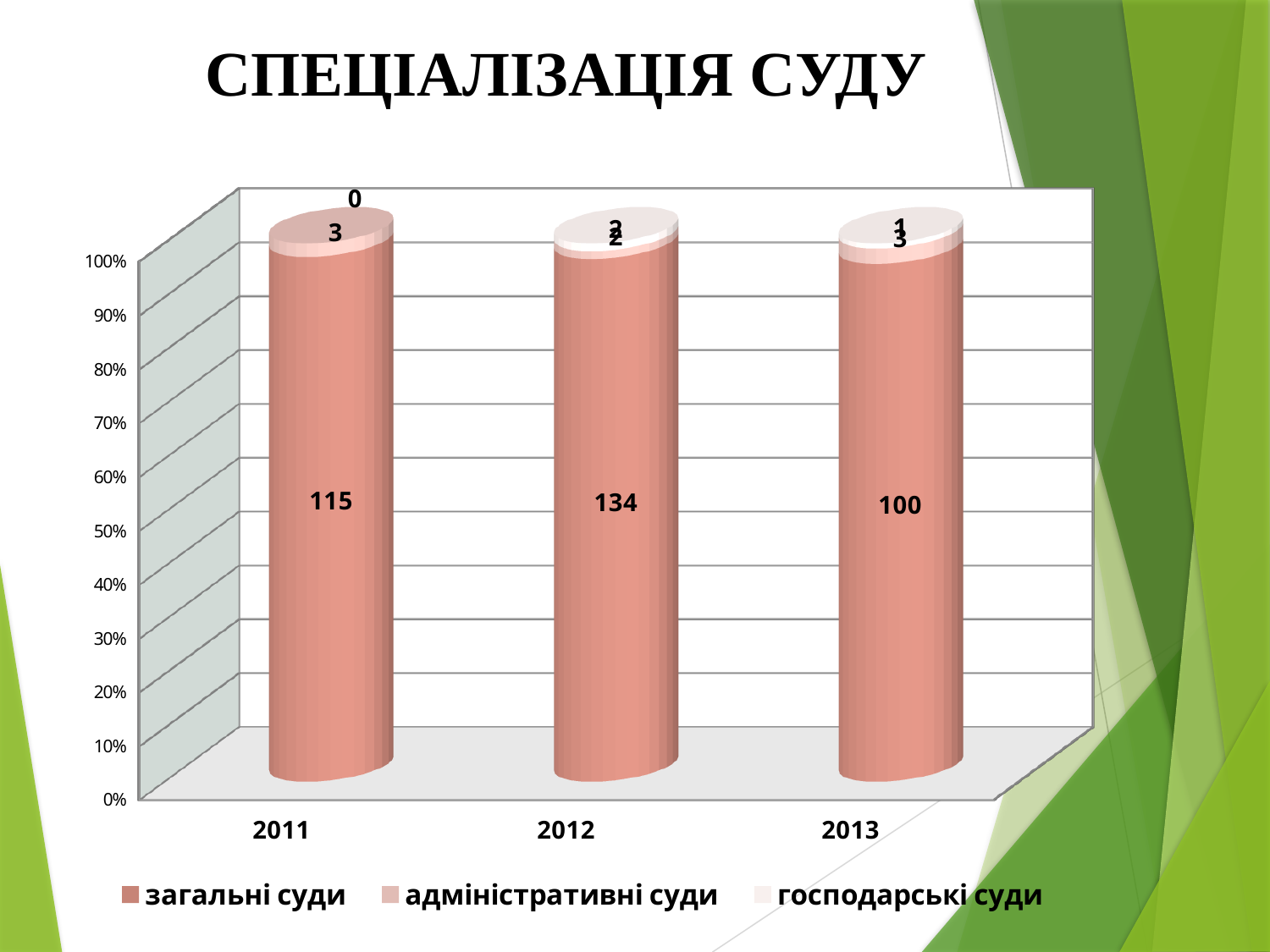
What is the value for загальні суди in 2012? 134 What is the difference between the загальні суди values for 2012 and 2013? 34 What is the value for загальні суди in 2013? 100 How many series does the legend list? 3 Which is larger for загальні суди: the value for 2011 or the value for 2013? 2011 What is the value for господарські суди in 2011? 0 What kind of chart is shown on the slide? bar chart Which year has the highest value for загальні суди? 2012 What is the value for загальні суди in 2011? 115 What is the difference between the загальні суди values for 2012 and 2011? 19 Which year has the lowest value for загальні суди? 2013 How many years are shown on the x axis? 3